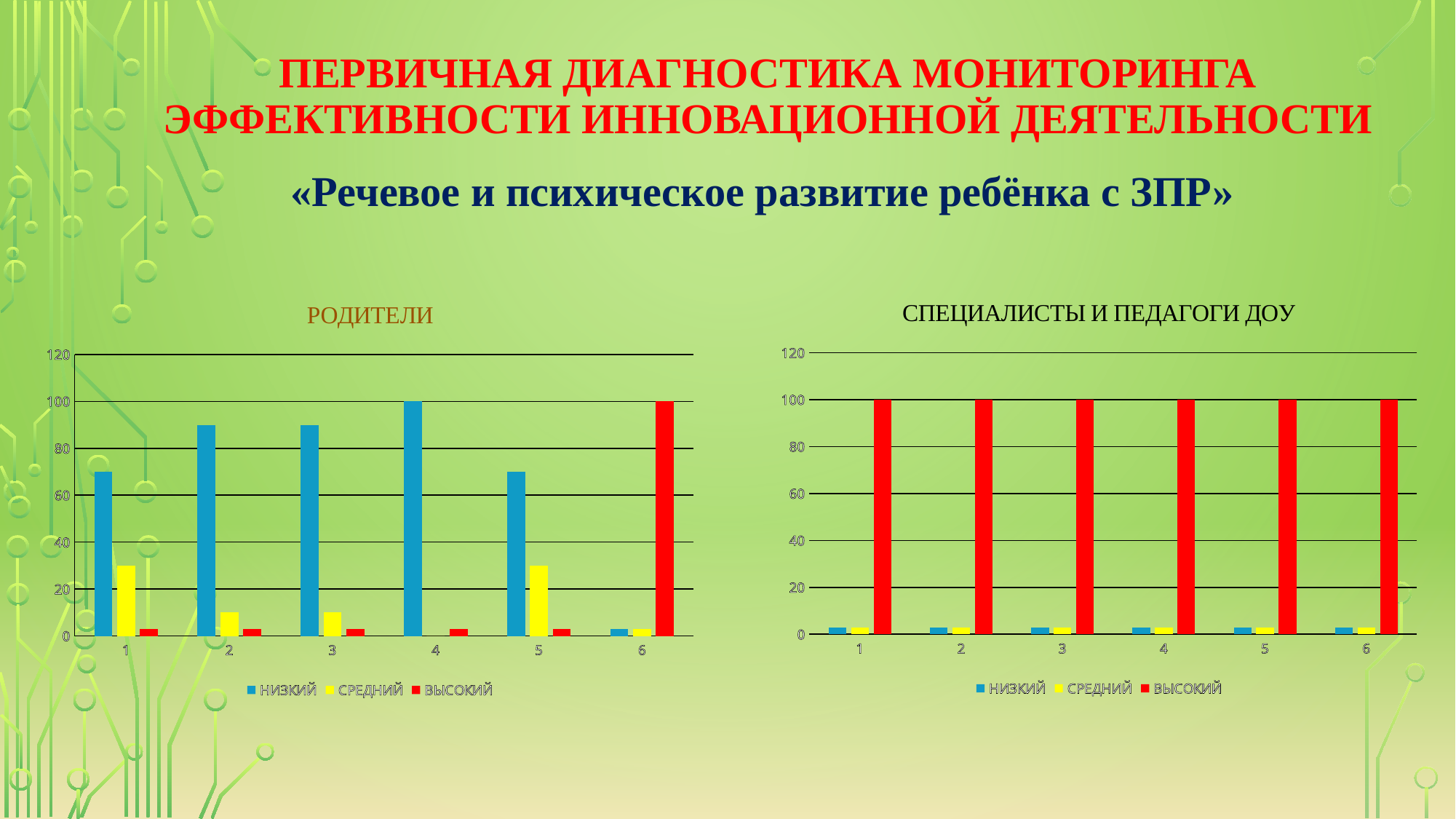
How many categories are shown on the x axis of the РОДИТЕЛИ chart? 6 In the РОДИТЕЛИ chart, what is the value of ВЫСОКИЙ for category 6? 100 In the РОДИТЕЛИ chart, which is larger for category 5: НИЗКИЙ or СРЕДНИЙ? НИЗКИЙ In the РОДИТЕЛИ chart, what is the value of НИЗКИЙ for category 4? 100 In the СПЕЦИАЛИСТЫ И ПЕДАГОГИ ДОУ chart, which series has the tallest bars in every category? ВЫСОКИЙ How many series does the legend of the СПЕЦИАЛИСТЫ И ПЕДАГОГИ ДОУ chart list? 3 In the РОДИТЕЛИ chart, is the value of СРЕДНИЙ for category 2 greater or less than 20? less In the РОДИТЕЛИ chart, which category has the highest НИЗКИЙ value? 4 In the СПЕЦИАЛИСТЫ И ПЕДАГОГИ ДОУ chart, what is the value of ВЫСОКИЙ for category 3? 100 What colour represents the СРЕДНИЙ series in the legend of the РОДИТЕЛИ chart? yellow In the РОДИТЕЛИ chart, is the value of НИЗКИЙ for category 1 greater or less than 60? greater What kind of chart is the РОДИТЕЛИ chart? bar chart